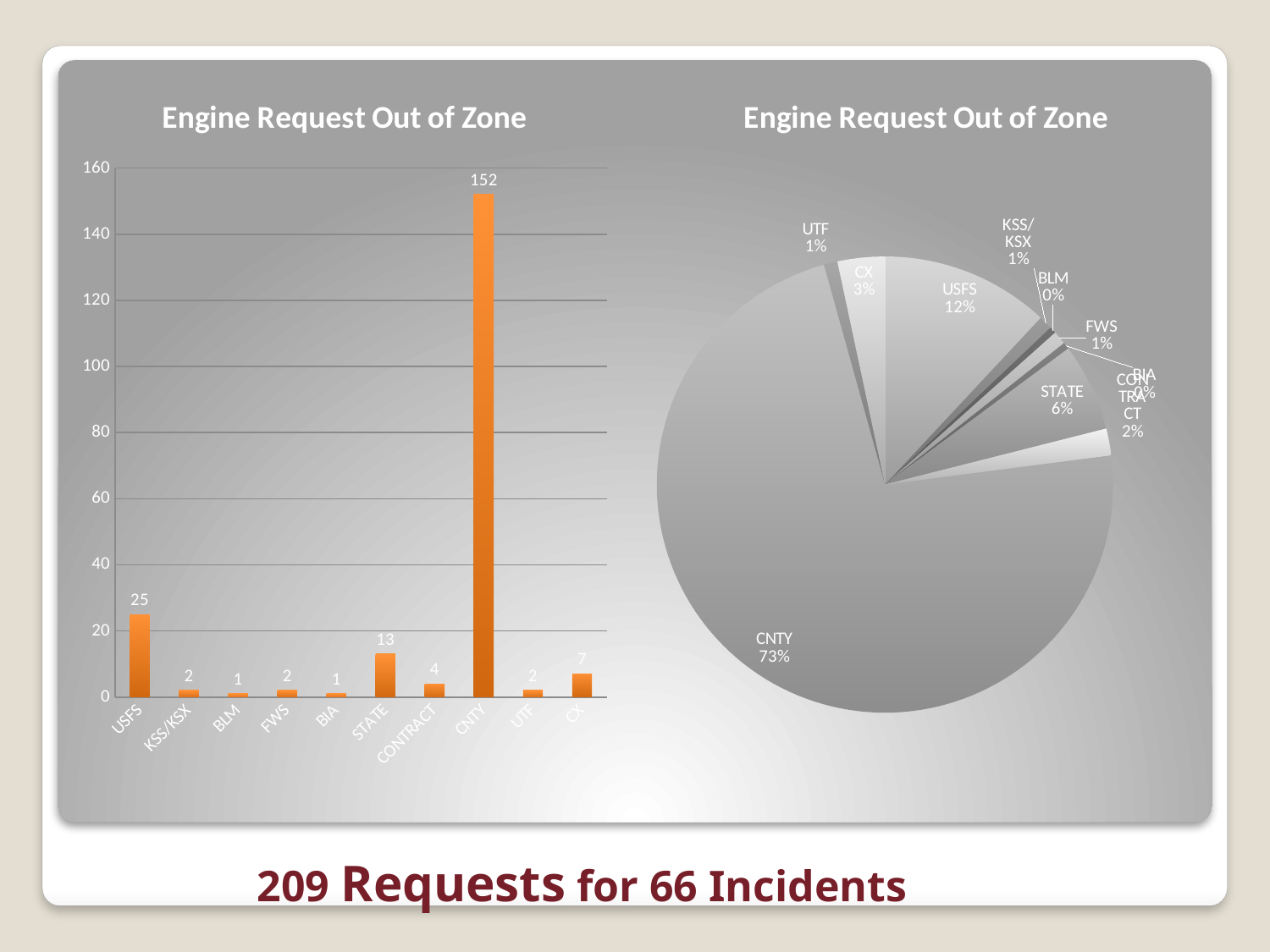
In the bar chart on the left, what is the value for STATE? 13 In the pie chart on the right, what share does CNTY have? 73% In the bar chart on the left, is the value for CNTY greater or less than 140? greater In the bar chart on the left, what is the value for USFS? 25 In the bar chart on the left, what is the difference between the values for CNTY and USFS? 127 In the pie chart on the right, what share does USFS have? 12% In the bar chart on the left, which category has the highest value? CNTY What is the title of the pie chart on the right? Engine Request Out of Zone In the bar chart on the left, what is the value for CNTY? 152 In the bar chart on the left, which is larger, the value for STATE or the value for CX? STATE What kind of chart is on the left side of the slide? bar chart How many categories are shown in the bar chart on the left? 10